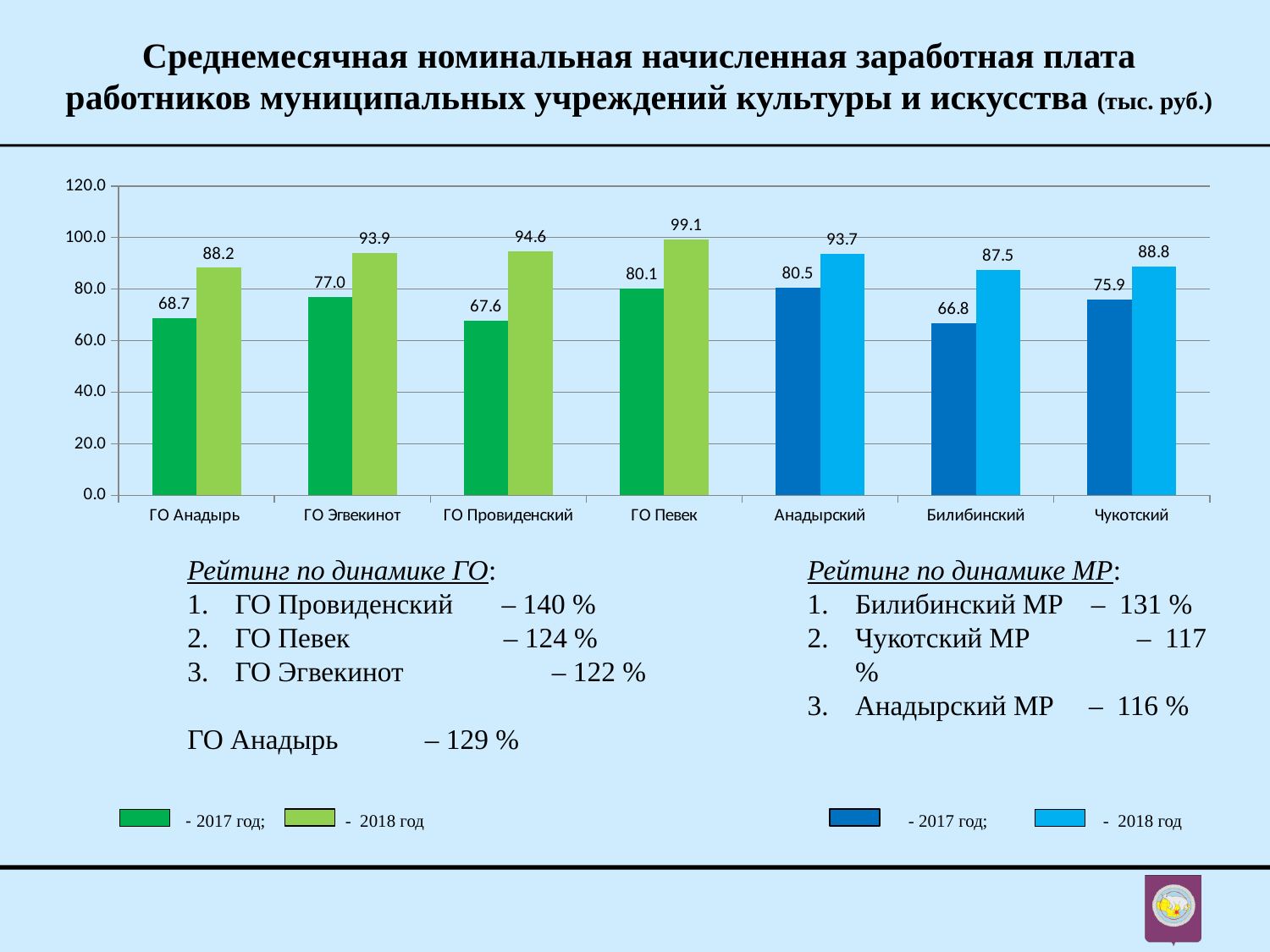
What kind of chart is shown on the slide? bar chart What is the difference between the 2018 and 2017 values for ГО Анадырь? 19.5 What is the 2017 value for Билибинский? 66.8 What is the 2017 value for Чукотский? 75.9 How many categories are shown on the x axis of the chart? 7 What is the 2018 value for ГО Провиденский? 94.6 Which category has the lowest 2017 value? Билибинский Which category has the highest 2018 value? ГО Певек What is the difference between the 2018 and 2017 values for ГО Провиденский? 27.0 What is the 2018 value for ГО Певек? 99.1 Which is larger: the 2017 value for ГО Певек or the 2017 value for Анадырский? Анадырский Is the 2018 value for Билибинский greater or less than 80.0? greater